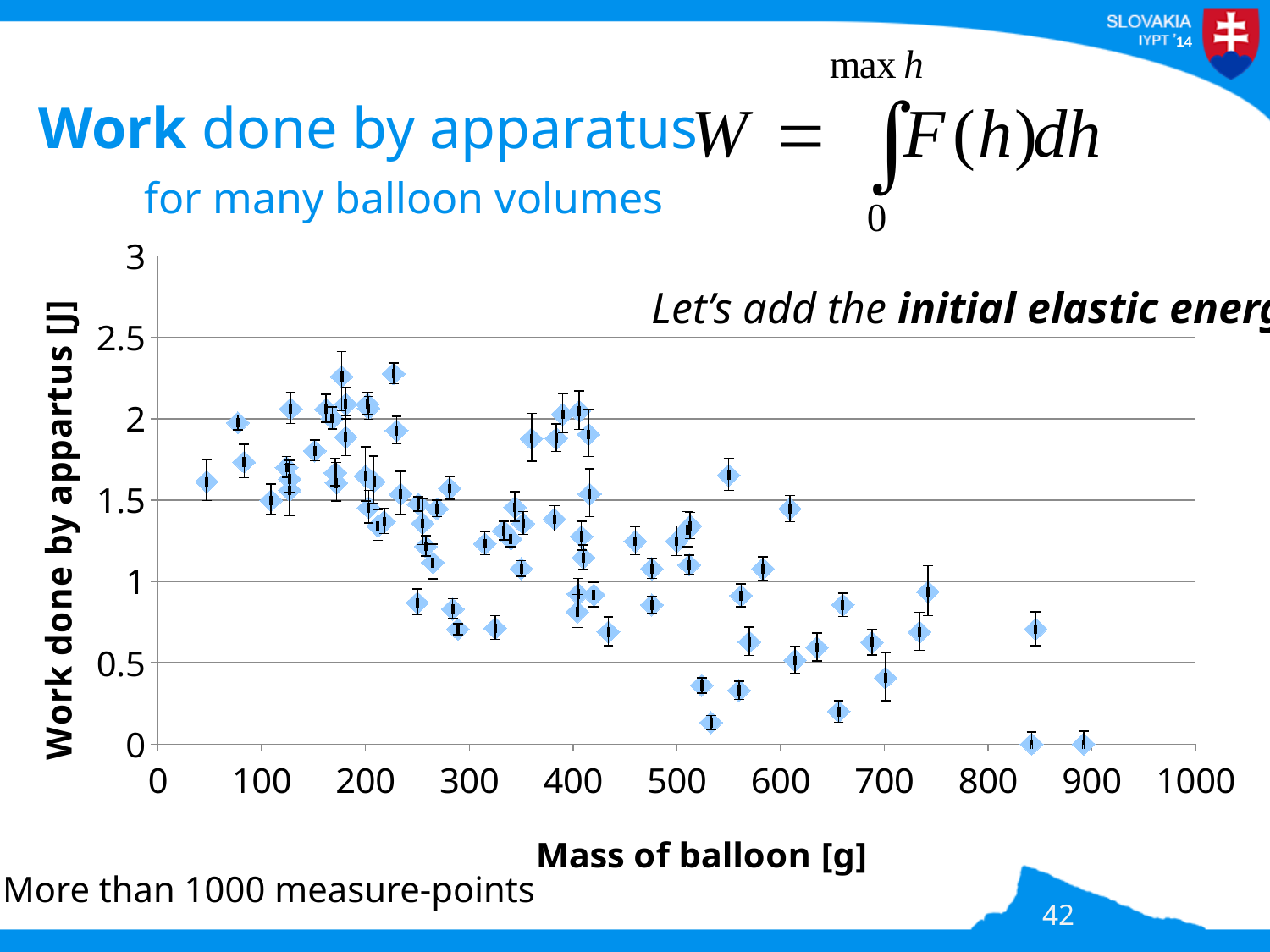
Is the highest plotted work value greater or less than 2.5 J? less Is the highest plotted work value greater or less than 2 J? greater What is the maximum value shown on the y axis of the chart? 3 What is the label of the y axis of the chart? Work done by appartus [J] Is the lowest plotted work value greater or less than 0.5 J? less What kind of chart is shown on the slide? Scatter plot As the mass of the balloon increases along the x axis, does the work done by the apparatus generally rise or fall? Fall What is the label of the x axis of the chart? Mass of balloon [g]